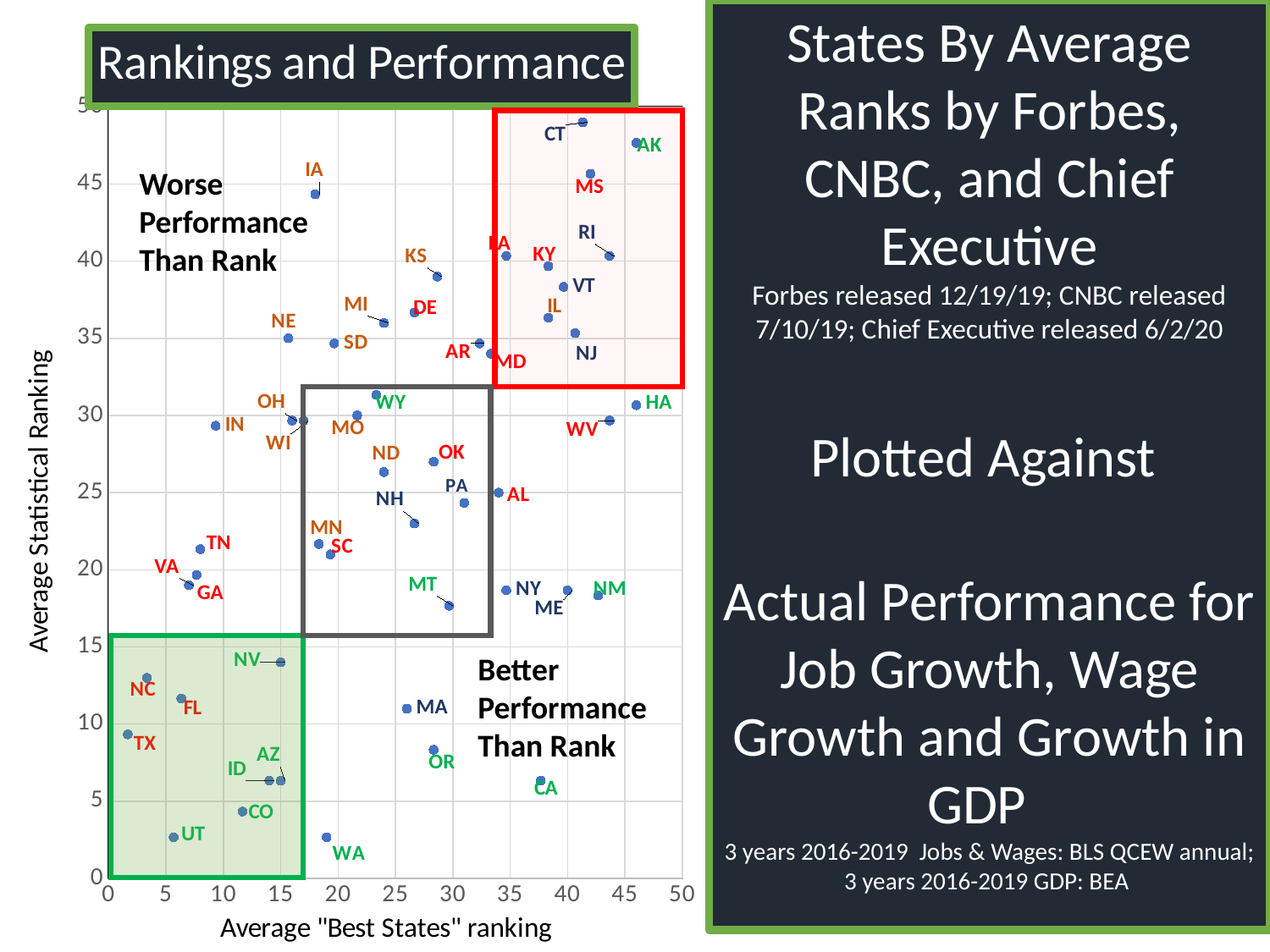
Is the Average Statistical Ranking for CT greater or less than 45? greater Is the Average "Best States" ranking for HA greater or less than 40? greater Is the Average Statistical Ranking for WA greater or less than 5? less What kind of chart is shown on the slide? scatter plot What is the label of the x axis of the chart? Average "Best States" ranking What is the title of the chart? Rankings and Performance Which state has the highest Average Statistical Ranking on the chart? CT Which state has a higher Average Statistical Ranking, CT or WA? CT